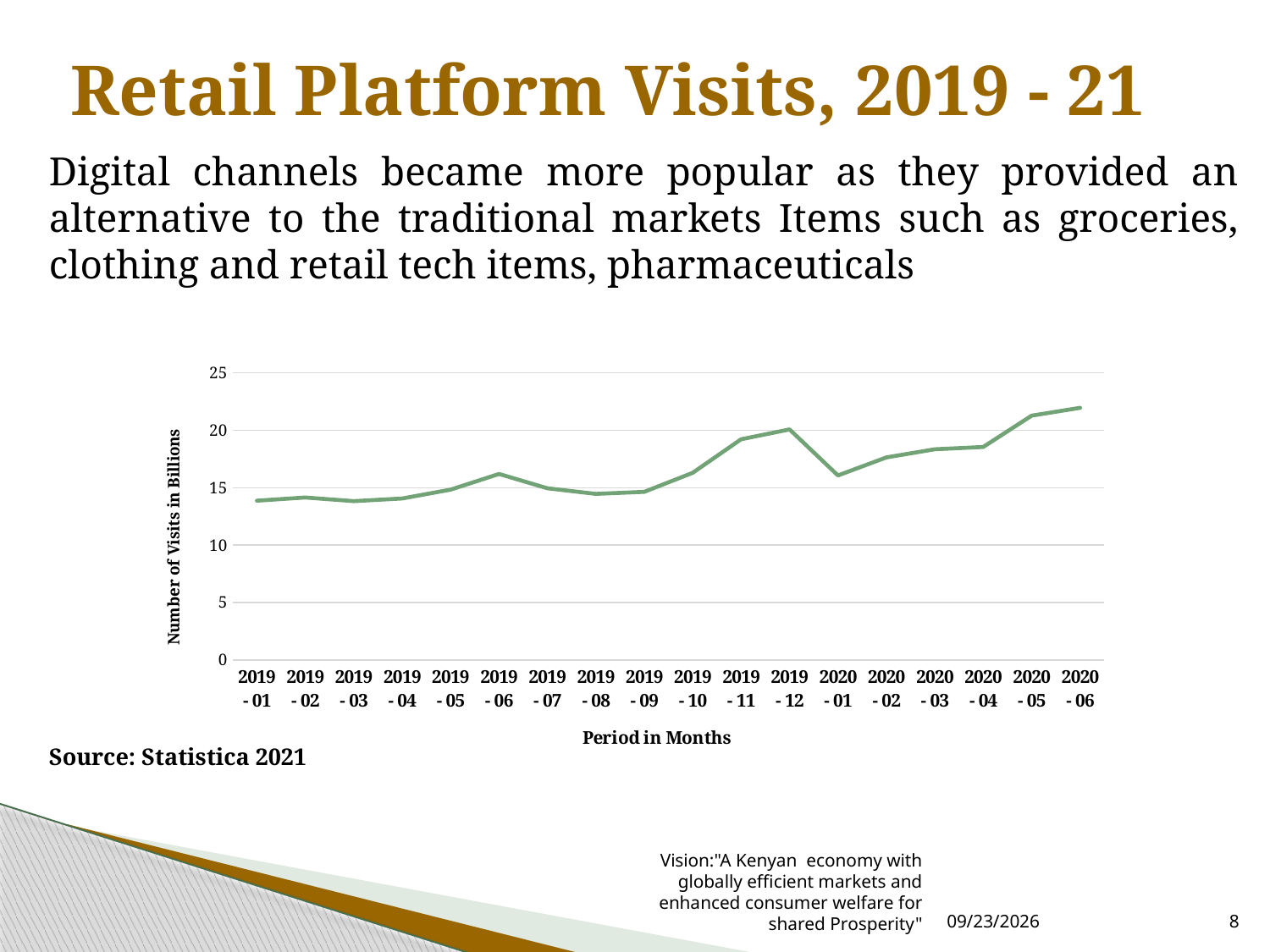
What is the title of the vertical axis? Number of Visits in Billions How many monthly data points are plotted on the chart? 18 Overall, do the values rise or fall from 2019 - 01 to 2020 - 06? rise Which is larger, the value for 2019 - 12 or the value for 2020 - 01? 2019 - 12 Which is larger, the value for 2020 - 05 or the value for 2019 - 06? 2020 - 05 Which month has the highest number of visits? 2020 - 06 Is the value for 2019 - 12 greater or less than 15? greater Is the value for 2020 - 03 greater or less than 20? less Is the value for 2019 - 01 greater or less than 15? less What kind of chart is shown on the slide? line chart